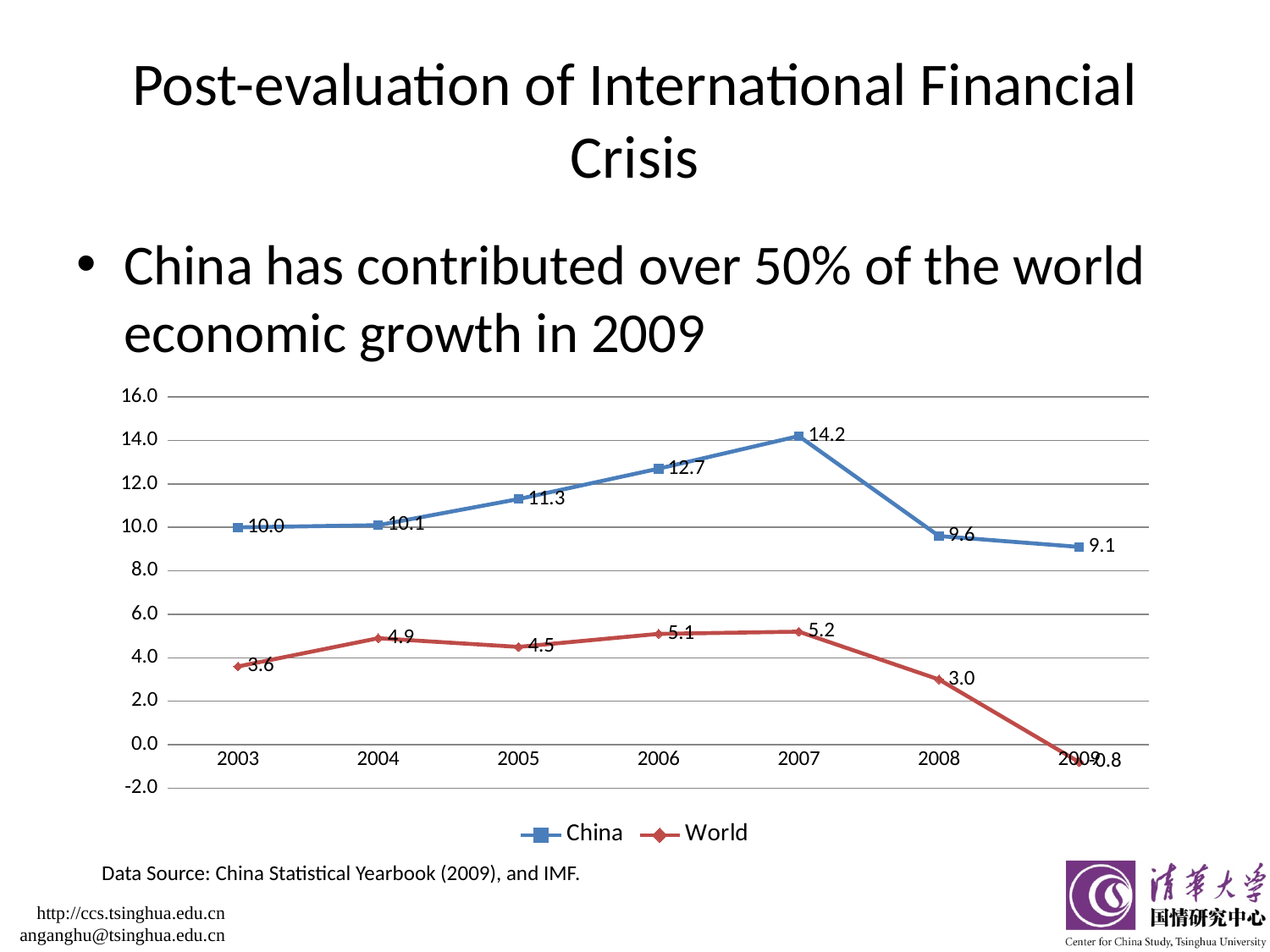
In which year does the China series reach its highest value? 2007 What kind of chart is shown on the slide? line chart How many years are shown on the x axis? 7 Is the value for China in 2005 greater or less than 12.0? less What is the value for China in 2007? 14.2 Does the World series rise or fall from 2007 to 2009? fall How many series does the legend list? 2 What is the value for World in 2004? 4.9 Which series has the larger value in 2006, China or World? China In which year does the World series reach its lowest value? 2009 What is the value for World in 2009? -0.8 What is the difference between the China and World values in 2008? 6.6